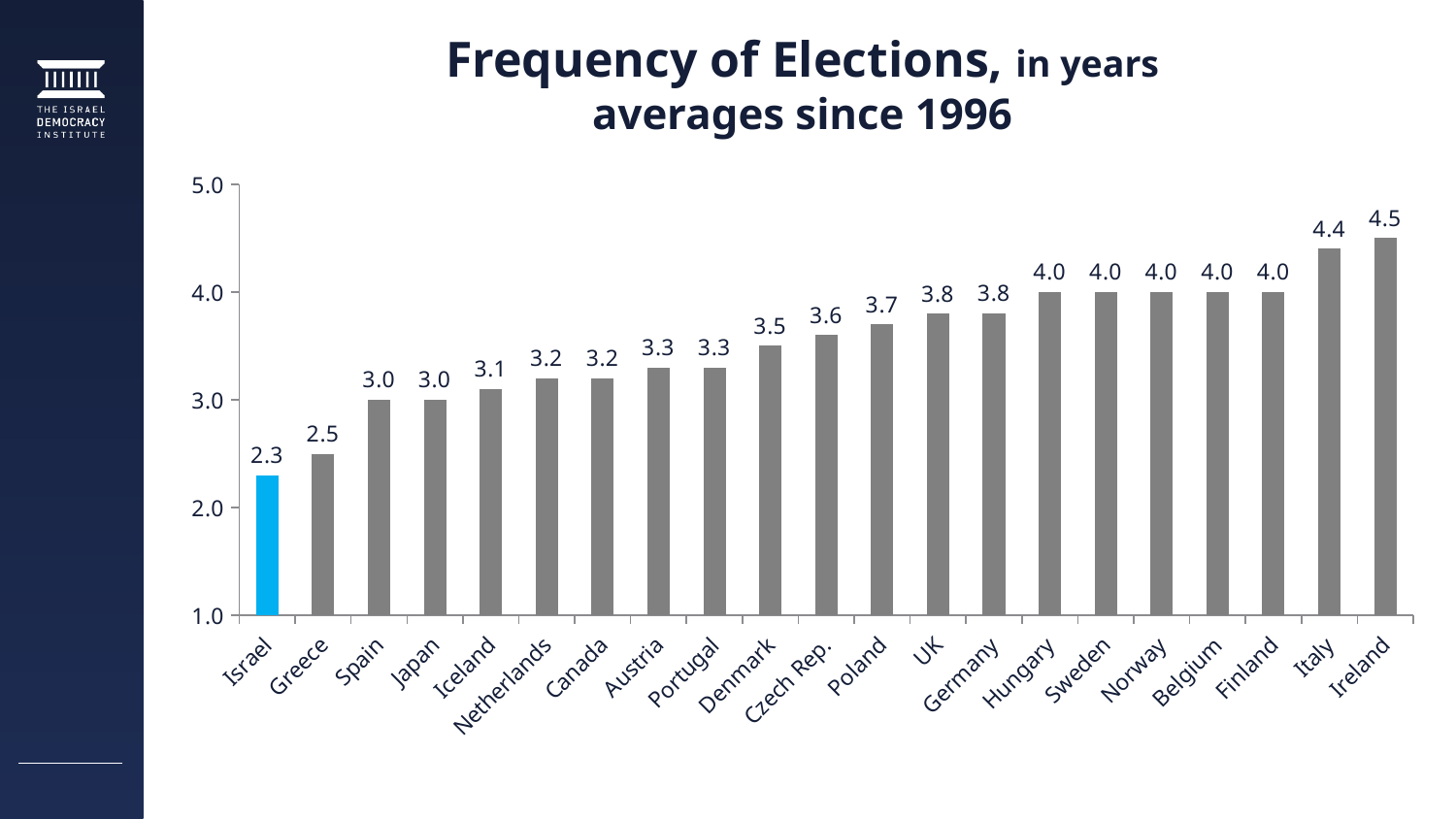
What is the value for Italy? 4.4 What is the difference between the values for Ireland and Israel? 2.2 What is the value for Israel? 2.3 Which country has the highest value? Ireland Which country has the lowest value? Israel Is the value for UK greater or less than 3.0? greater What kind of chart is shown on the slide? Bar chart What is the difference between the values for Poland and Greece? 1.2 How many countries are shown in the chart? 21 Do the values rise or fall from left to right along the x axis? Rise Which is larger, the value for Denmark or the value for Iceland? Denmark What is the value for Czech Rep.? 3.6